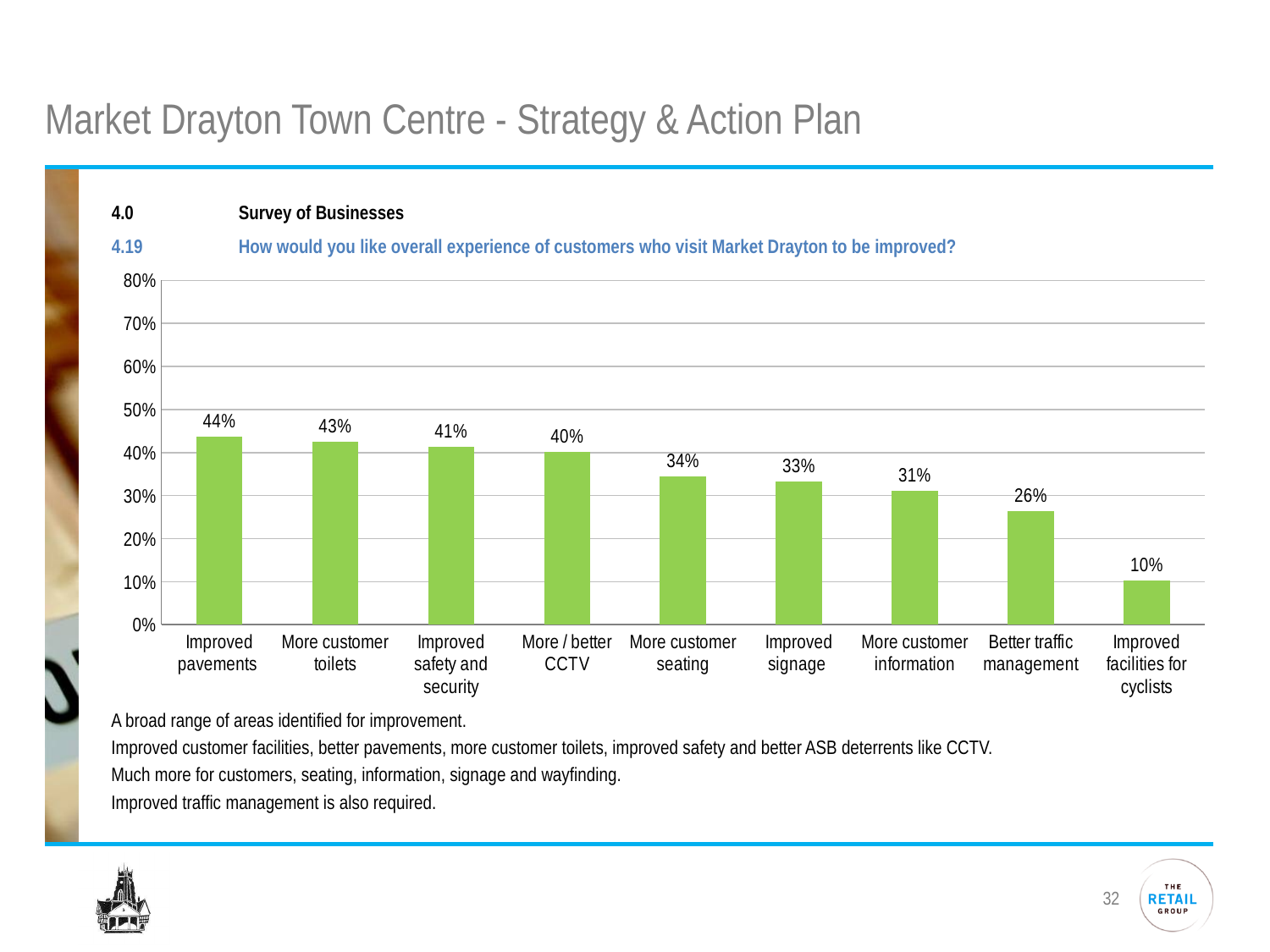
What is the difference between 'Improved safety and security' and 'More customer information'? 10% Do the values rise or fall from left to right across the categories? Fall What kind of chart is shown on the slide? Bar chart Which category has the highest value? Improved pavements What is the difference between 'More customer toilets' and 'Improved facilities for cyclists'? 33% Is the value for 'More customer information' greater or less than 40%? less What is the value shown for 'More customer seating'? 34% Which is larger, 'More / better CCTV' or 'Improved signage'? More / better CCTV What percentage of businesses selected 'Improved pavements'? 44% How many categories are shown on the chart? 9 Which category has the lowest value? Improved facilities for cyclists What is the value shown for 'Better traffic management'? 26%